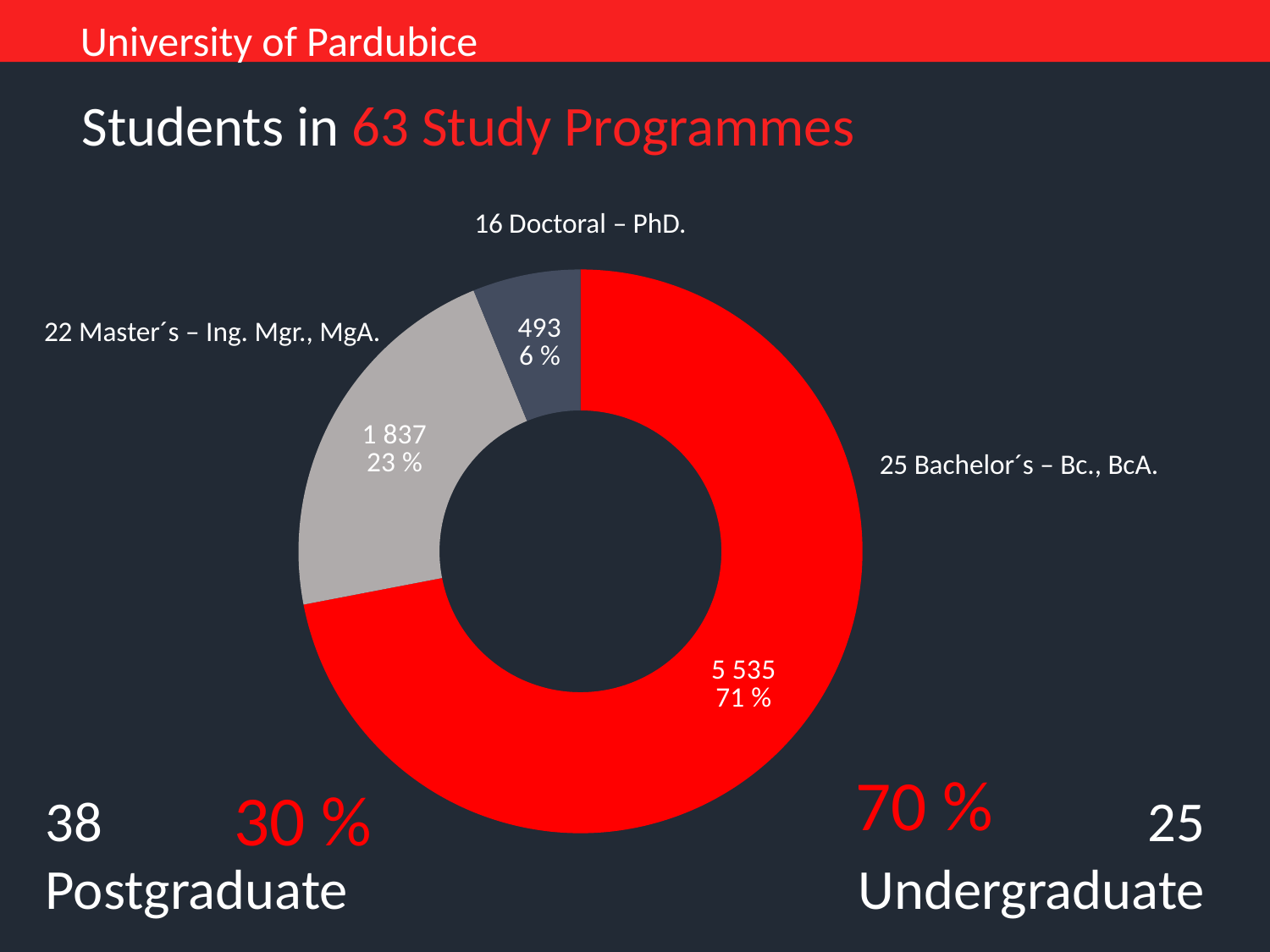
How many slices does the chart have? 3 How many students are in the Bachelor´s – Bc., BcA. slice? 5 535 Which slice of the chart is the largest? Bachelor´s – Bc., BcA. What share of the chart does the Bachelor´s – Bc., BcA. slice represent? 71 % What is the difference in students between the Master´s – Ing. Mgr., MgA. slice and the Doctoral – PhD. slice? 1 344 How many students are in the Doctoral – PhD. slice? 493 Which slice of the chart is the smallest? Doctoral – PhD. What kind of chart is shown on the slide? Doughnut (pie) chart How many students are in the Master´s – Ing. Mgr., MgA. slice? 1 837 Which slice has more students, Master´s – Ing. Mgr., MgA. or Doctoral – PhD.? Master´s – Ing. Mgr., MgA. What share of the chart does the Master´s – Ing. Mgr., MgA. slice represent? 23 % What share of the chart does the Doctoral – PhD. slice represent? 6 %